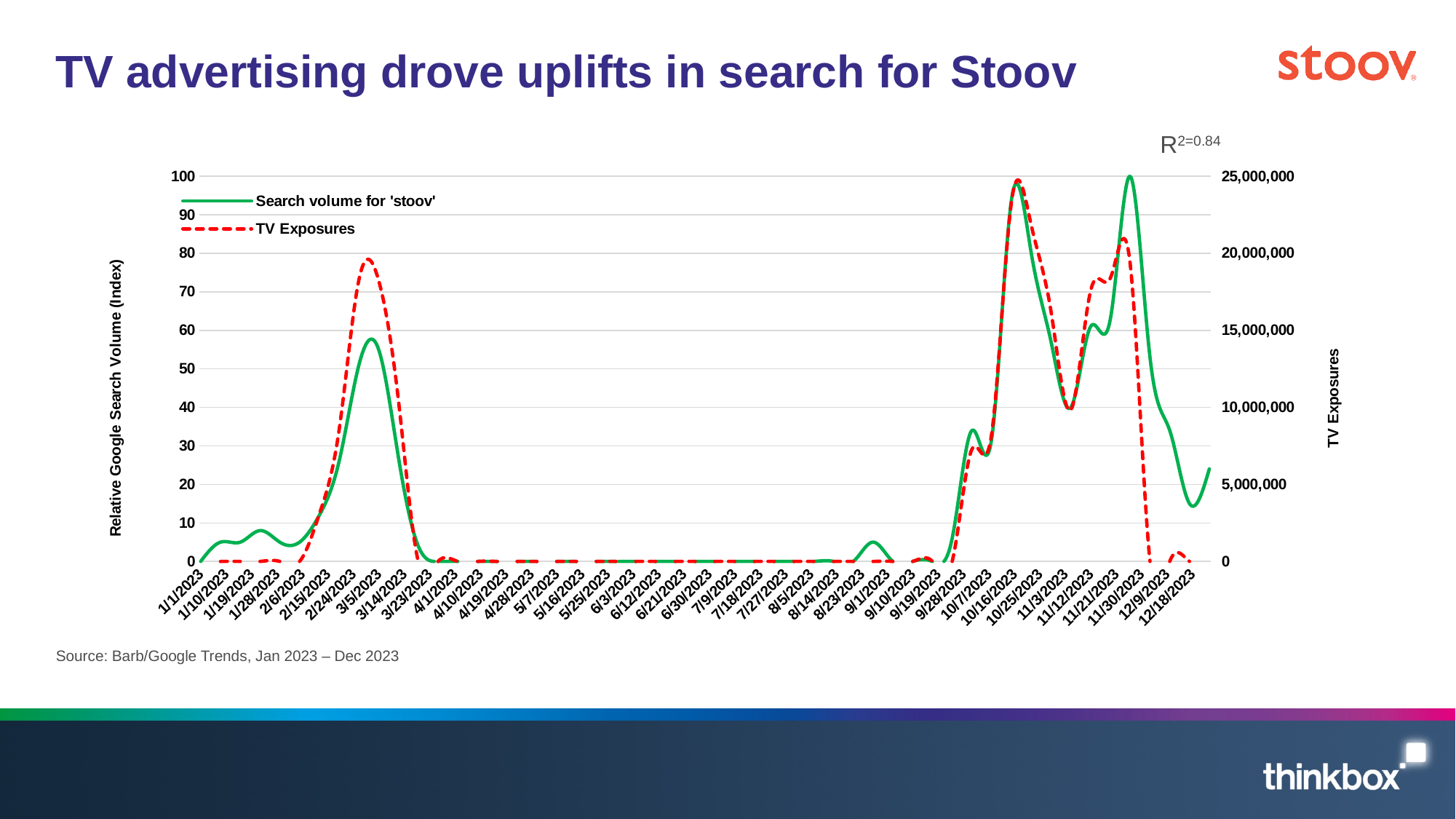
How many series does the legend list? 2 What is the highest value reached by the 'Search volume for stoov' line on the left axis? 100 What kind of chart is shown on the slide? Line chart Which is higher for 'Search volume for stoov': the peak in early March 2023 or the peak in late November 2023? Late November 2023 Is the 'TV Exposures' value at its early-March peak (around 3/5/2023) greater or less than 15,000,000? greater Is the 'Search volume for stoov' value at its early-March peak (around 3/5/2023) greater or less than 50? greater Does the 'Search volume for stoov' line rise or fall between 10/16/2023 and 11/3/2023? Fall Around which date label does the 'Search volume for stoov' line reach its peak of 100? 11/30/2023 How many date labels are shown on the x axis? 40 What R-squared value is shown on the chart? 0.84 Is the 'TV Exposures' value around 11/12/2023 greater or less than 15,000,000? greater